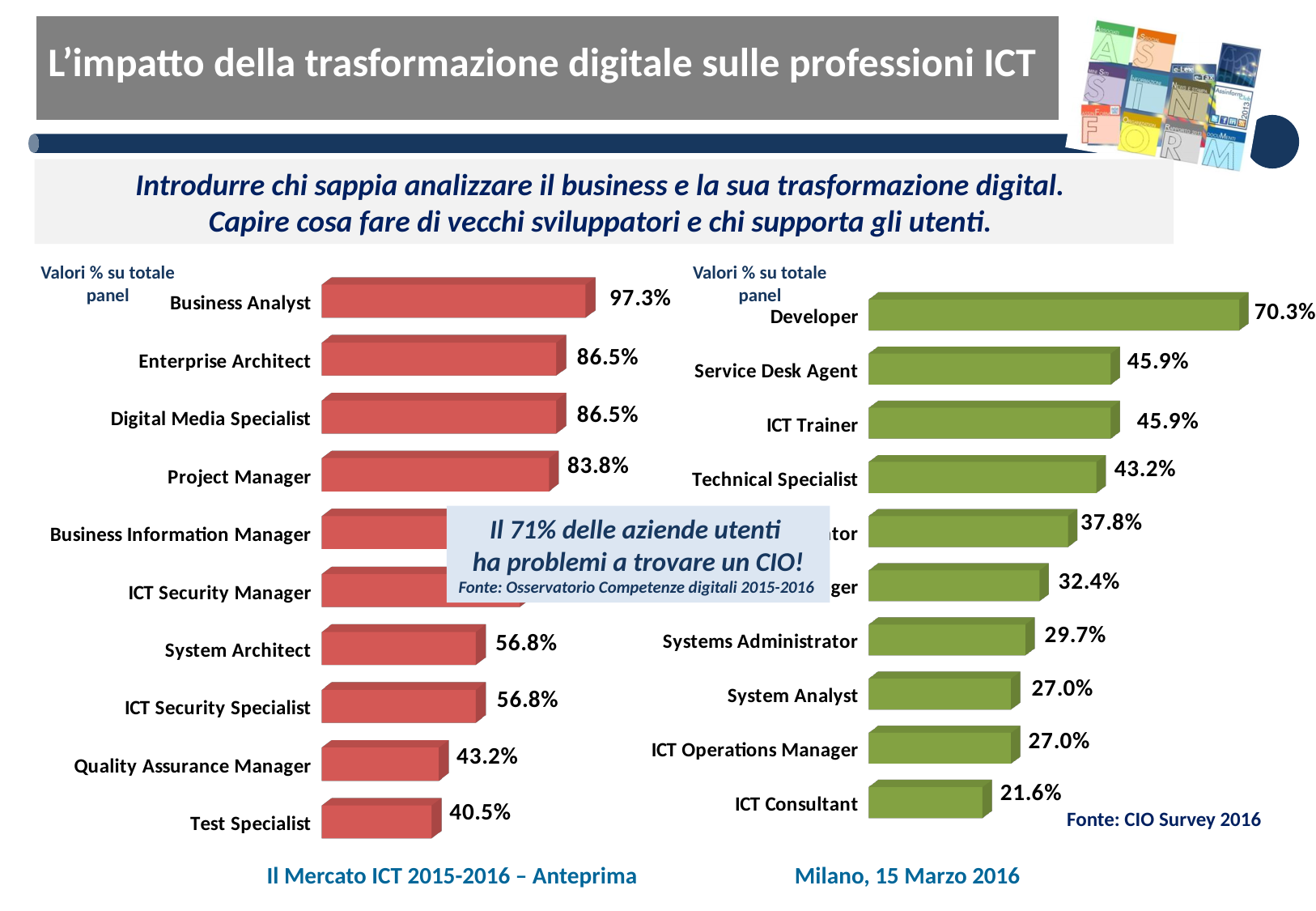
In the left chart (red bars), what is the value for Business Analyst? 97.3% In the right chart (green bars), what is the value for ICT Consultant? 21.6% In the left chart (red bars), which category has the highest value? Business Analyst What kind of chart is the left chart (red bars)? Bar chart In the right chart (green bars), which is larger: Technical Specialist or Systems Administrator? Technical Specialist How many categories are shown in the right chart (green bars)? 10 In the right chart (green bars), what is the value for Developer? 70.3% In the left chart (red bars), what is the value for Quality Assurance Manager? 43.2% In the left chart (red bars), what is the difference between Business Analyst and Test Specialist? 56.8% What source is cited below the right chart (green bars)? Fonte: CIO Survey 2016 In the right chart (green bars), what is the difference between Developer and Service Desk Agent? 24.4% In the right chart (green bars), which category has the lowest value? ICT Consultant